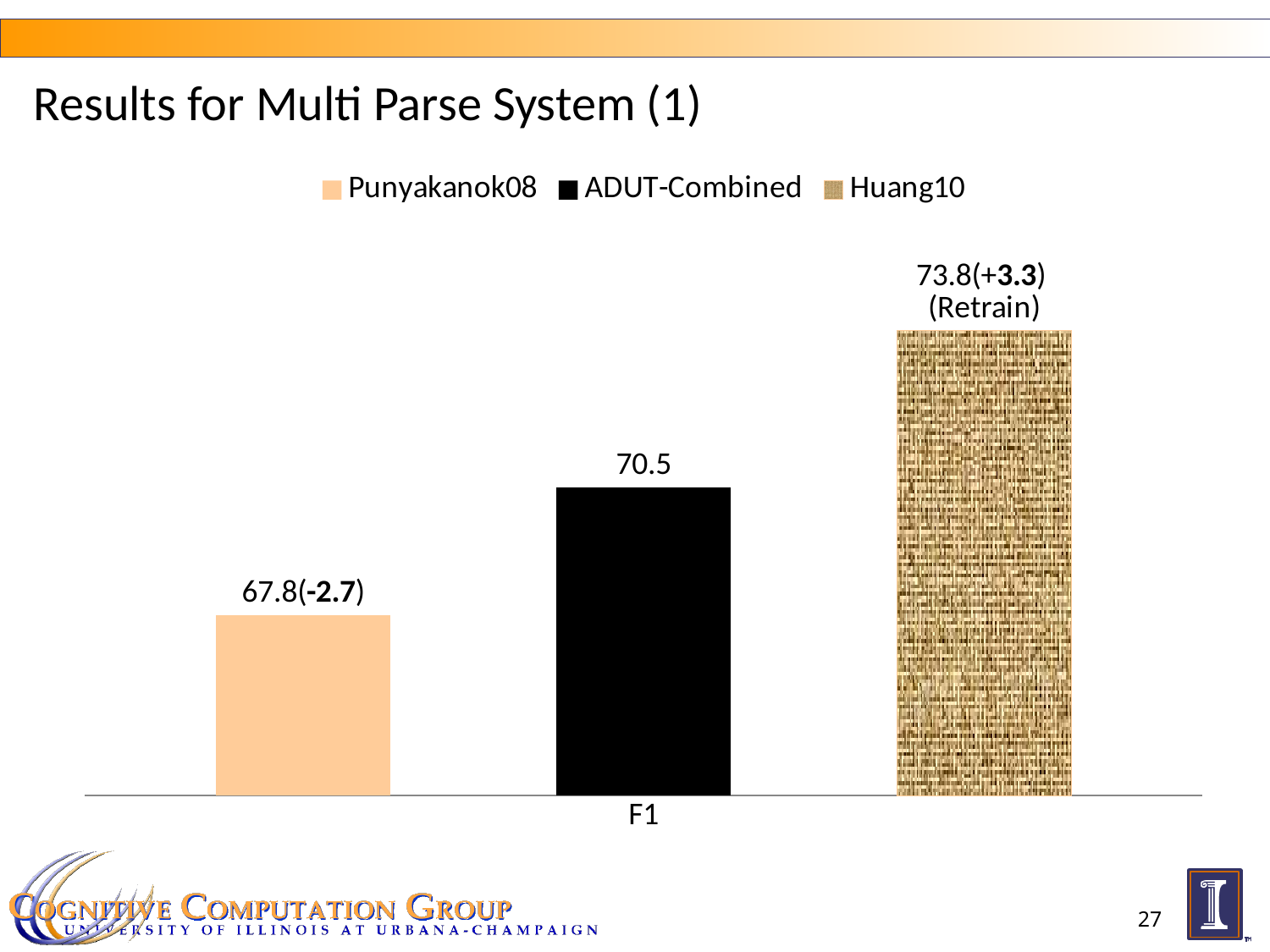
What is the difference between the F1 values of ADUT-Combined and Punyakanok08? 2.7 What is the title of the slide containing the chart? Results for Multi Parse System (1) What is the F1 value for Huang10? 73.8 Which has a higher F1 value, Punyakanok08 or ADUT-Combined? ADUT-Combined What is the category label on the x axis? F1 What is the difference between the F1 values of Huang10 and ADUT-Combined? 3.3 What kind of chart is shown on the slide? Bar chart Which series has the lowest F1 value? Punyakanok08 Which series has the highest F1 value? Huang10 What is the F1 value for Punyakanok08? 67.8 How many series does the legend list? 3 What is the F1 value for ADUT-Combined? 70.5